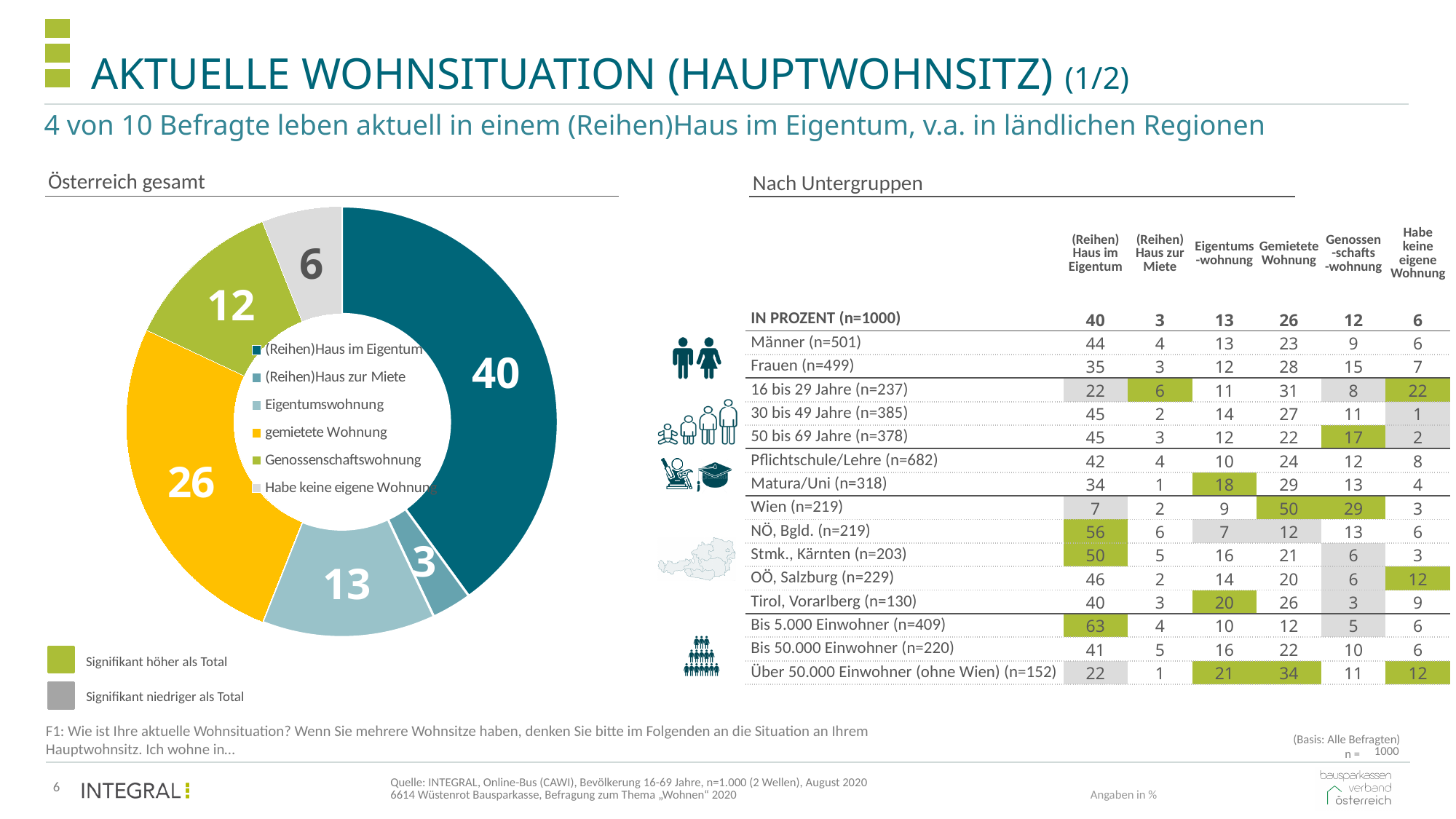
In the "Österreich gesamt" chart, which category has the smallest share? (Reihen)Haus zur Miete What kind of chart is shown under "Österreich gesamt"? Pie (donut) chart In the "Österreich gesamt" chart, what is the value for (Reihen)Haus zur Miete? 3 In the "Österreich gesamt" chart, what is the difference between the values for (Reihen)Haus im Eigentum and gemietete Wohnung? 14 In the "Österreich gesamt" chart, what is the value for Genossenschaftswohnung? 12 How many categories does the "Österreich gesamt" chart show? 6 In the "Österreich gesamt" chart, which category has the largest share? (Reihen)Haus im Eigentum In the "Österreich gesamt" chart, what is the value for (Reihen)Haus im Eigentum? 40 In the "Österreich gesamt" chart, what is the value for Eigentumswohnung? 13 In the "Österreich gesamt" chart, what colour is the gemietete Wohnung segment? Yellow In the "Österreich gesamt" chart, what is the value for gemietete Wohnung? 26 In the "Österreich gesamt" chart, which is larger: Eigentumswohnung or Genossenschaftswohnung? Eigentumswohnung